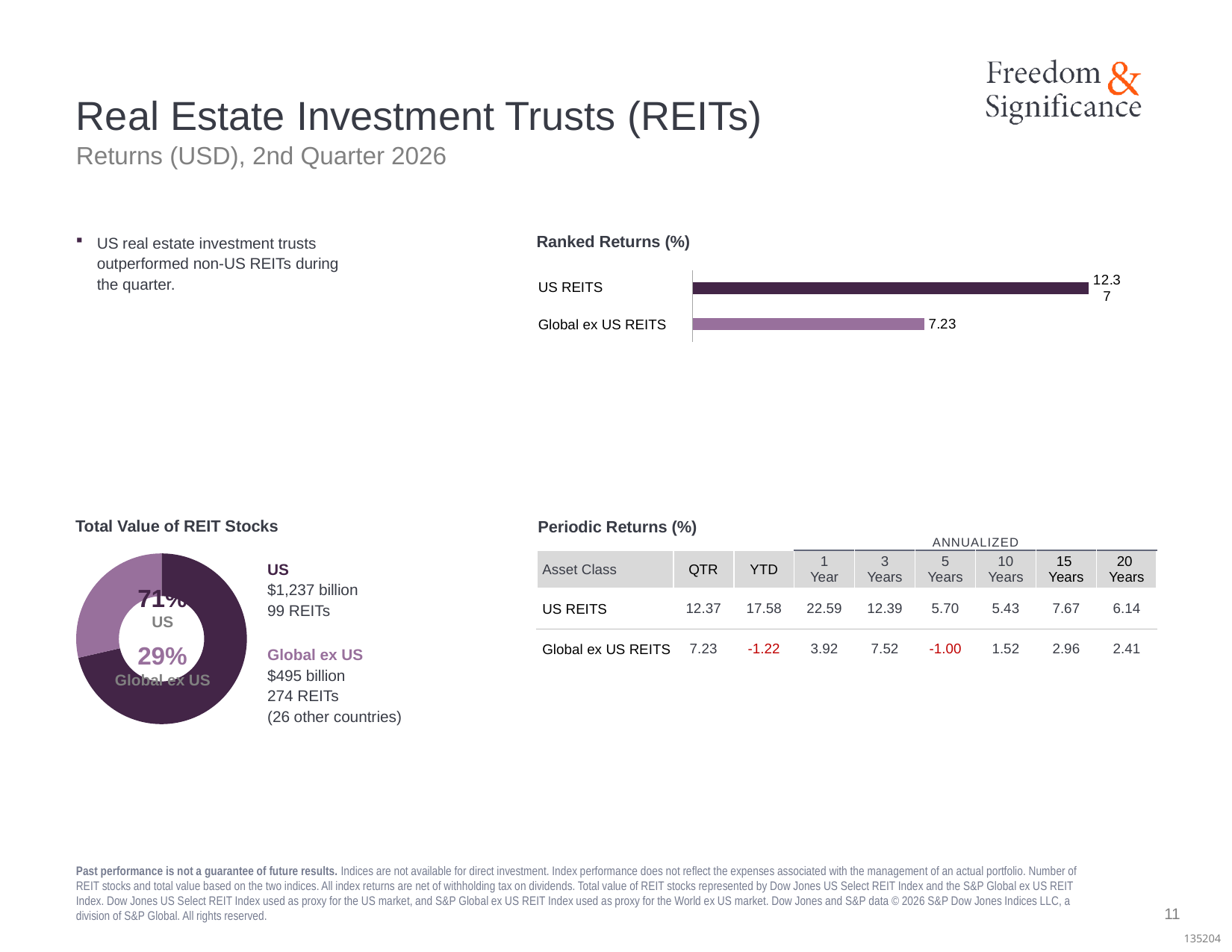
In the Ranked Returns (%) chart, what is the value for Global ex US REITS? 7.23 In the Total Value of REIT Stocks chart, what share does US represent? 71% In the Ranked Returns (%) chart, which category has the highest value? US REITS In the Ranked Returns (%) chart, which is larger: US REITS or Global ex US REITS? US REITS In the Ranked Returns (%) chart, what is the difference between the US REITS and Global ex US REITS values? 5.14 In the Total Value of REIT Stocks chart, what share does Global ex US represent? 29% In the Total Value of REIT Stocks chart, which segment is larger: US or Global ex US? US In the Ranked Returns (%) chart, which category has the lowest value? Global ex US REITS What kind of chart is the Ranked Returns (%) chart? Bar chart What kind of chart is the Total Value of REIT Stocks chart? Doughnut chart In the Ranked Returns (%) chart, what is the value for US REITS? 12.37 How many categories are shown in the Ranked Returns (%) chart? 2